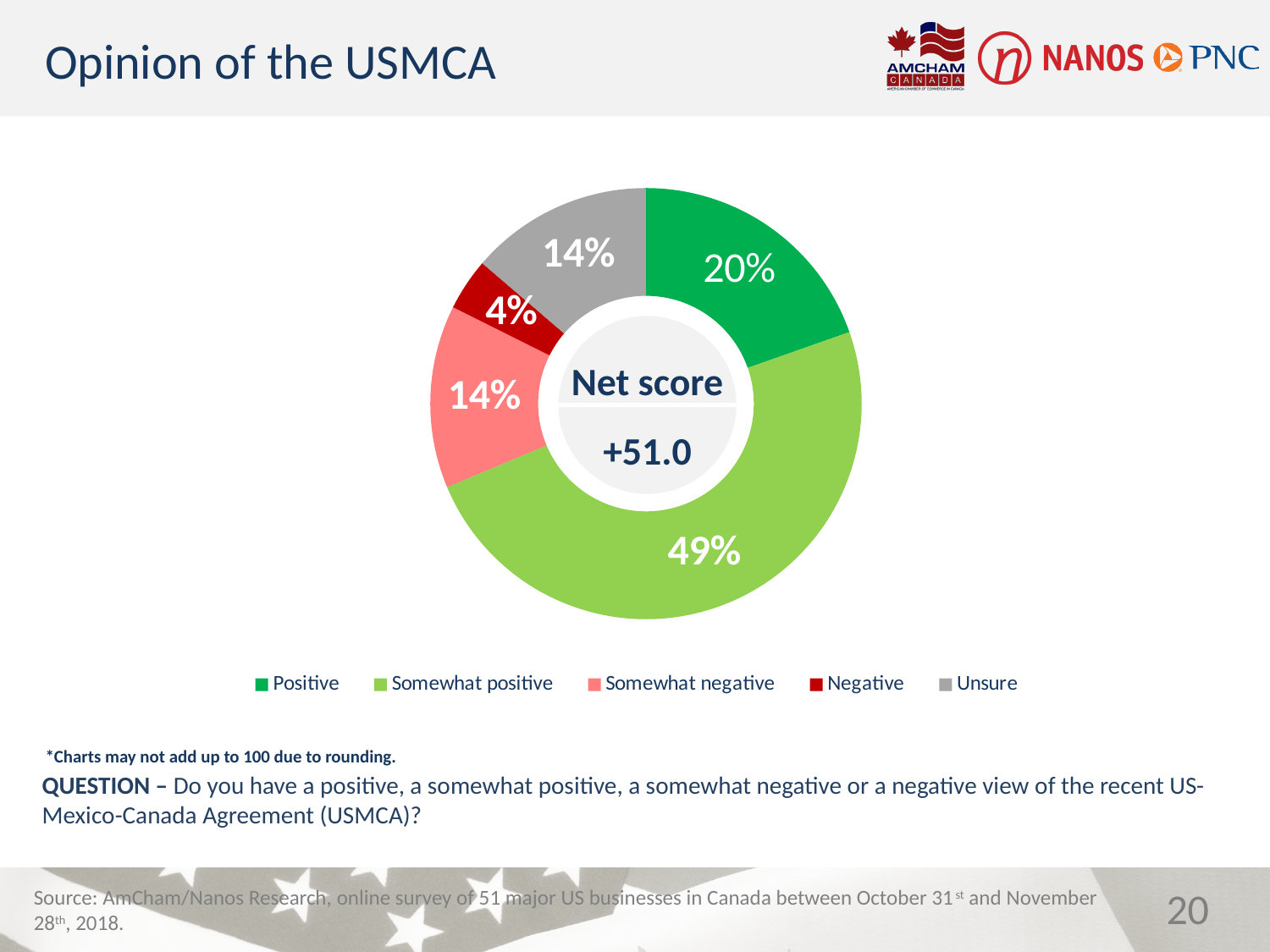
What percentage of respondents are unsure about the USMCA? 14% What percentage of respondents have a negative view of the USMCA? 4% What is the difference in percentage points between the somewhat positive and positive shares? 29 What percentage of respondents have a somewhat negative view of the USMCA? 14% Which response category has the smallest share of the pie? Negative Which is larger, the share for Positive or the share for Negative? Positive What kind of chart is shown on the slide? Doughnut chart How many categories does the legend list? 5 What percentage of respondents have a positive view of the USMCA? 20% Which response category has the largest share of the pie? Somewhat positive What net score is shown in the centre of the chart? +51.0 What percentage of respondents have a somewhat positive view of the USMCA? 49%